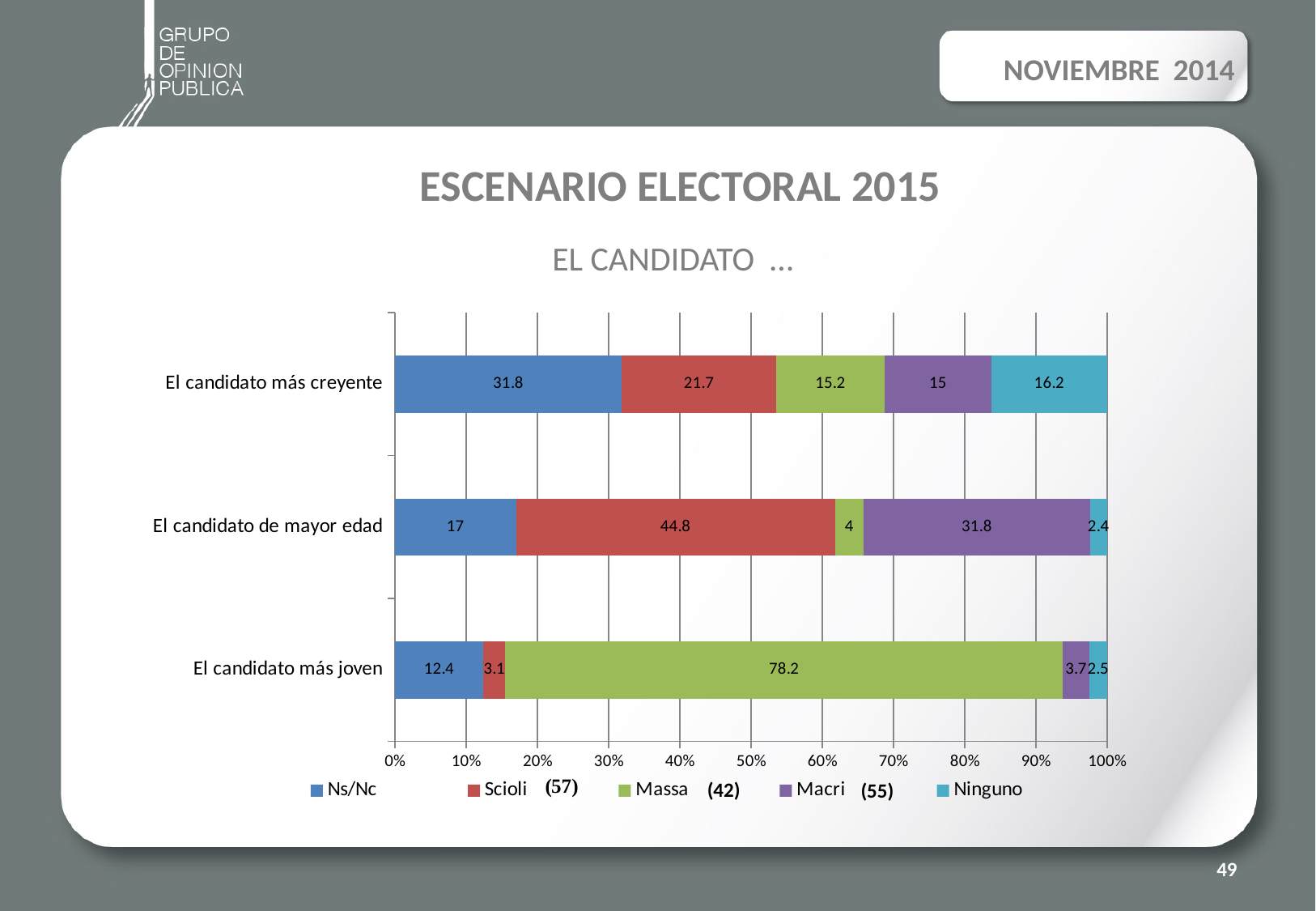
What kind of chart is shown on the slide? Stacked bar chart In the 'El candidato de mayor edad' bar, what is the difference between the Macri value and the Massa value? 27.8 In the 'El candidato más creyente' bar, which is larger: the Scioli value or the Ninguno value? Scioli Which series has the lowest value in the 'El candidato más joven' bar? Ninguno What is the main title shown above the chart? ESCENARIO ELECTORAL 2015 What is the value for Massa in the 'El candidato más joven' bar? 78.2 How many categories (bars) are shown in the chart? 3 Which series has the highest value in the 'El candidato de mayor edad' bar? Scioli What is the total of the 'El candidato de mayor edad' stacked bar? 100 What is the value for Scioli in the 'El candidato de mayor edad' bar? 44.8 What is the Ns/Nc value for 'El candidato más creyente'? 31.8 How many series does the legend list? 5